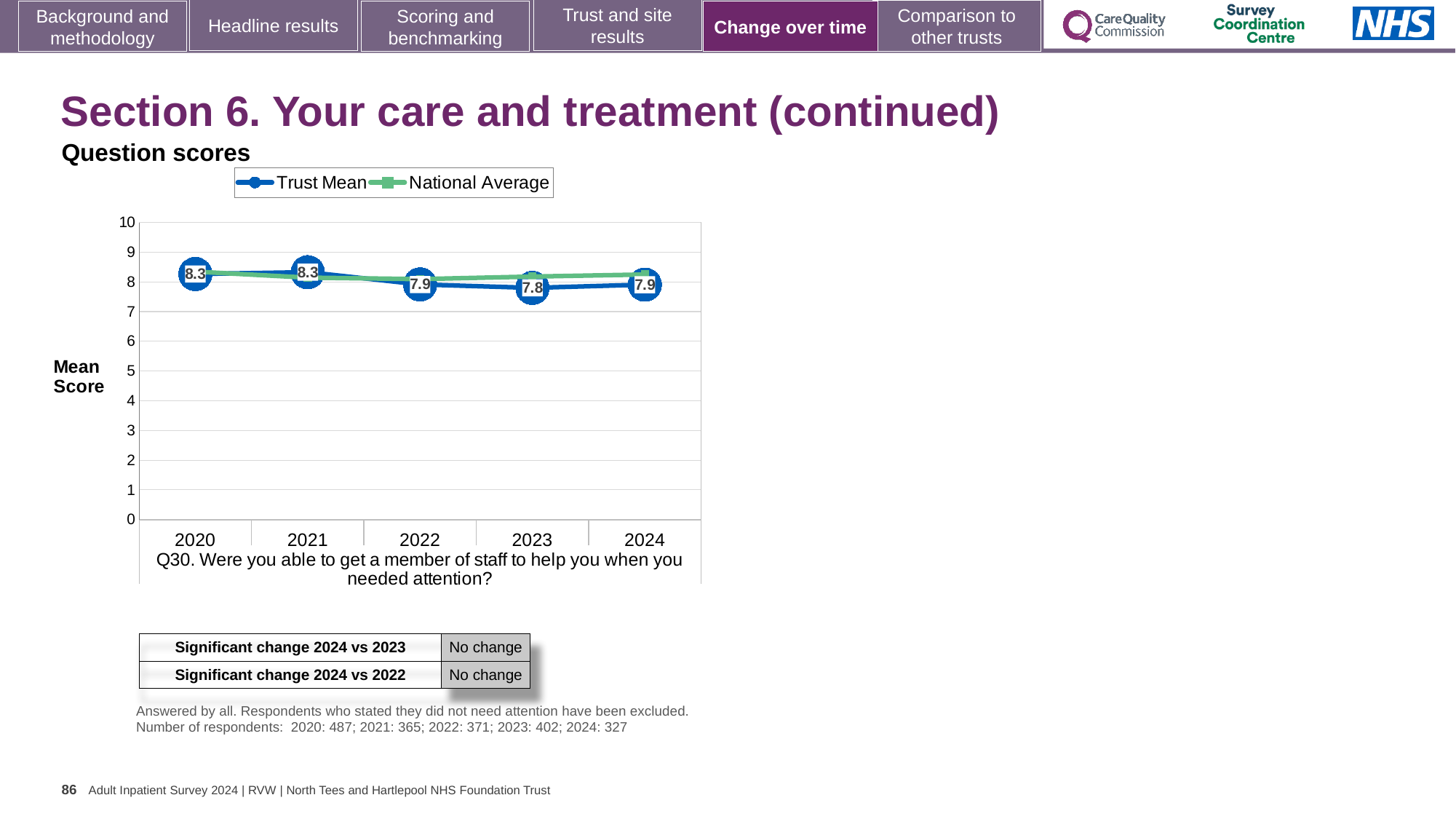
How many series does the legend list? 2 Which is larger, the Trust Mean score for 2021 or for 2023? 2021 What is the difference between the Trust Mean score in 2020 and in 2023? 0.5 What is the label on the y axis? Mean Score In which year is the Trust Mean score lowest? 2023 Is the National Average value for 2024 greater or less than 7? greater Does the Trust Mean score rise or fall from 2020 to 2024? fall What is the Trust Mean score for 2020? 8.3 What is the Trust Mean score for 2023? 7.8 What is the Trust Mean score for 2024? 7.9 What kind of chart is shown? line chart How many years are plotted on the x axis? 5